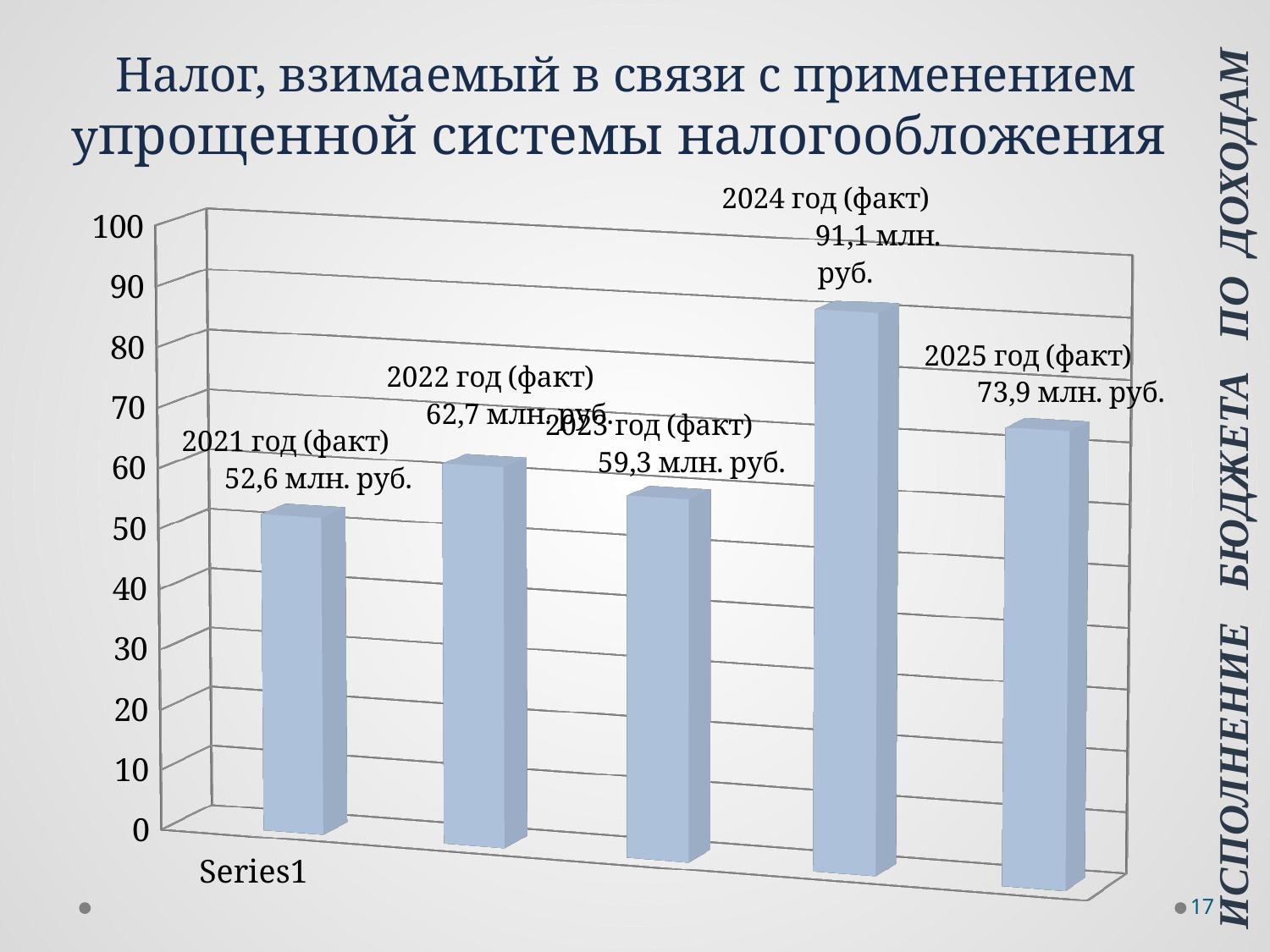
Is the value for 2024 год (факт) greater or less than 80? greater Which year has the highest value? 2024 год (факт) What is the difference between the values for 2024 год (факт) and 2025 год (факт)? 17,2 млн. руб. What is the value for 2024 год (факт)? 91,1 млн. руб. Which is larger, the value for 2022 год (факт) or 2023 год (факт)? 2022 год (факт) Which year has the lowest value? 2021 год (факт) How many bars are shown in the chart? 5 What is the title of the chart? Налог, взимаемый в связи с применением упрощенной системы налогообложения What kind of chart is shown on the slide? bar chart What is the value for 2021 год (факт)? 52,6 млн. руб. What is the difference between the values for 2022 год (факт) and 2021 год (факт)? 10,1 млн. руб. What is the value for 2025 год (факт)? 73,9 млн. руб.